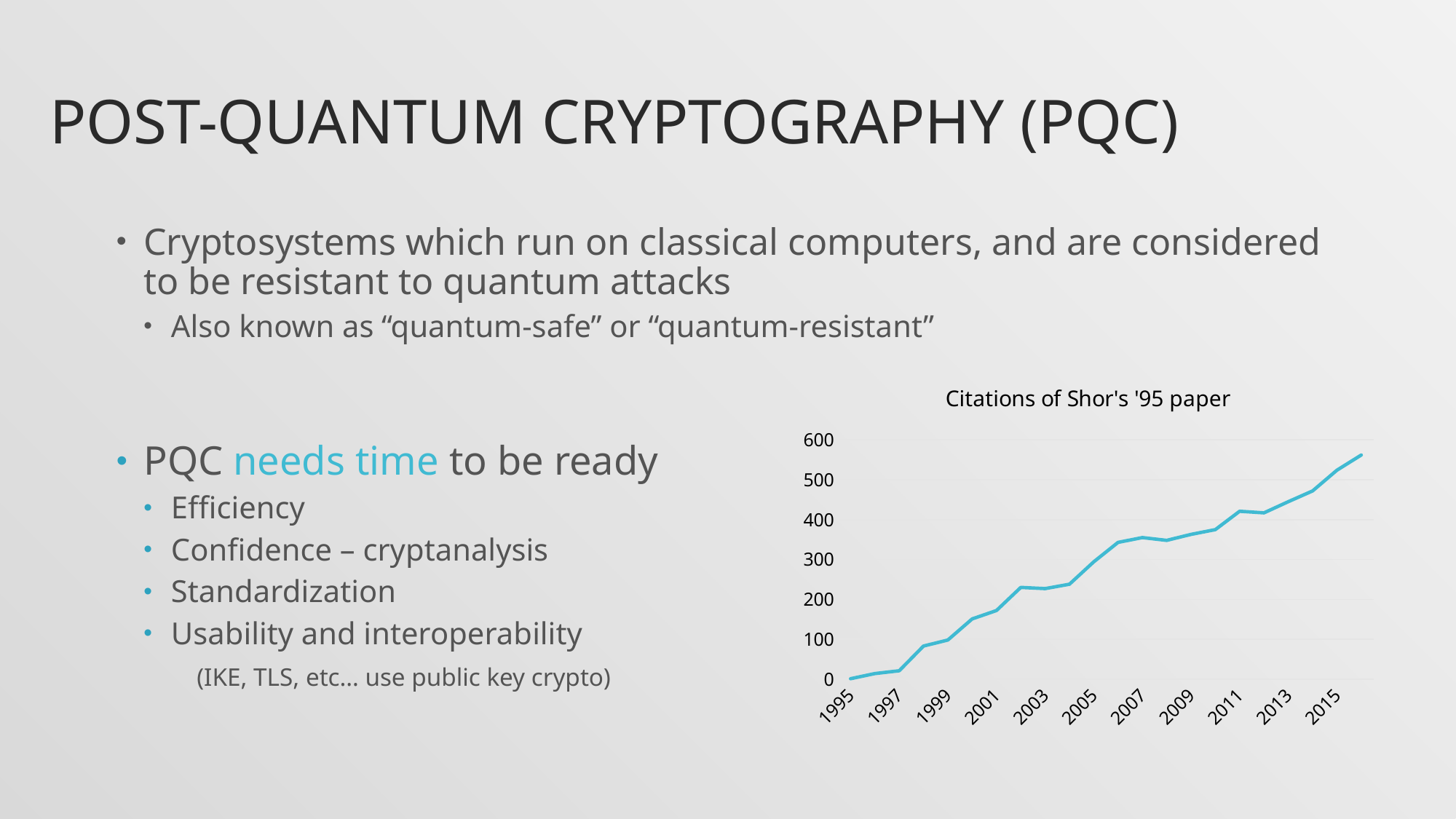
Which labelled year has the lowest number of citations? 1995 What is the title of the chart on the slide? Citations of Shor's '95 paper Is the value for 1995 greater or less than 100? less Is the value for 2015 greater or less than 400? greater Which year has more citations, 2005 or 2015? 2015 What kind of chart is shown on the slide? line chart Is the value for 1999 greater or less than 200? less Do the citation values generally rise or fall from 1995 to 2015? rise What is the highest value shown on the y axis of the chart? 600